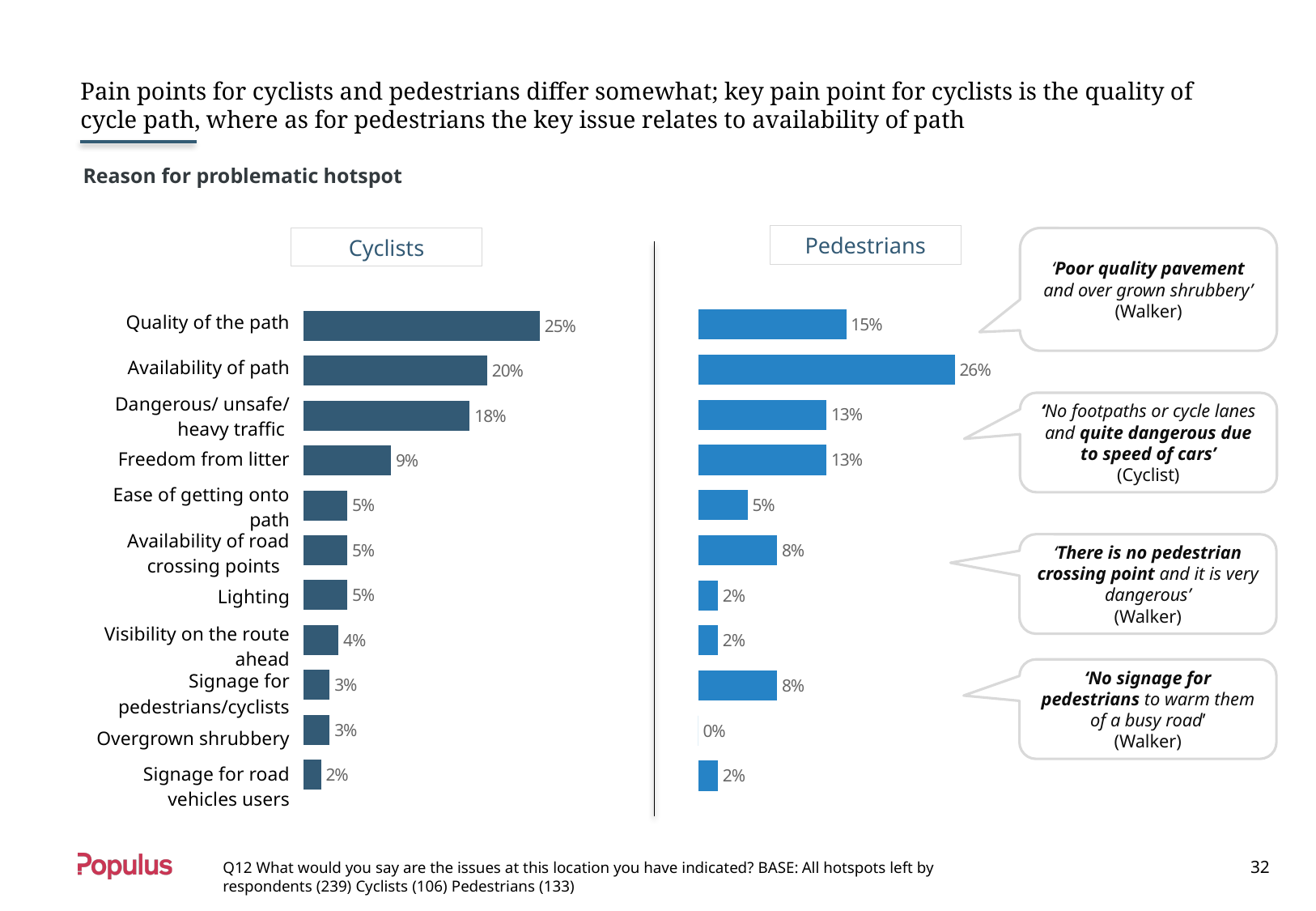
In the Cyclists chart, which reason has the lowest percentage? Signage for road vehicles users Which is larger: the Pedestrians value for Availability of road crossing points or the Cyclists value for Availability of road crossing points? Pedestrians In the Pedestrians chart, what percentage is shown for Overgrown shrubbery? 0% In the Pedestrians chart, which reason has the highest percentage? Availability of path How many reasons for problematic hotspot are listed in the Cyclists chart? 11 In the Pedestrians chart, what percentage is shown for Availability of path? 26% In the Cyclists chart, which reason has the highest percentage? Quality of the path In the Cyclists chart, what percentage is shown for Quality of the path? 25% In the Cyclists chart, what percentage is shown for Freedom from litter? 9% What is the difference between the Cyclists and Pedestrians percentages for Quality of the path? 10% In the Pedestrians chart, which reason has the lowest percentage? Overgrown shrubbery What type of chart is used to show the reasons for problematic hotspot? Bar chart